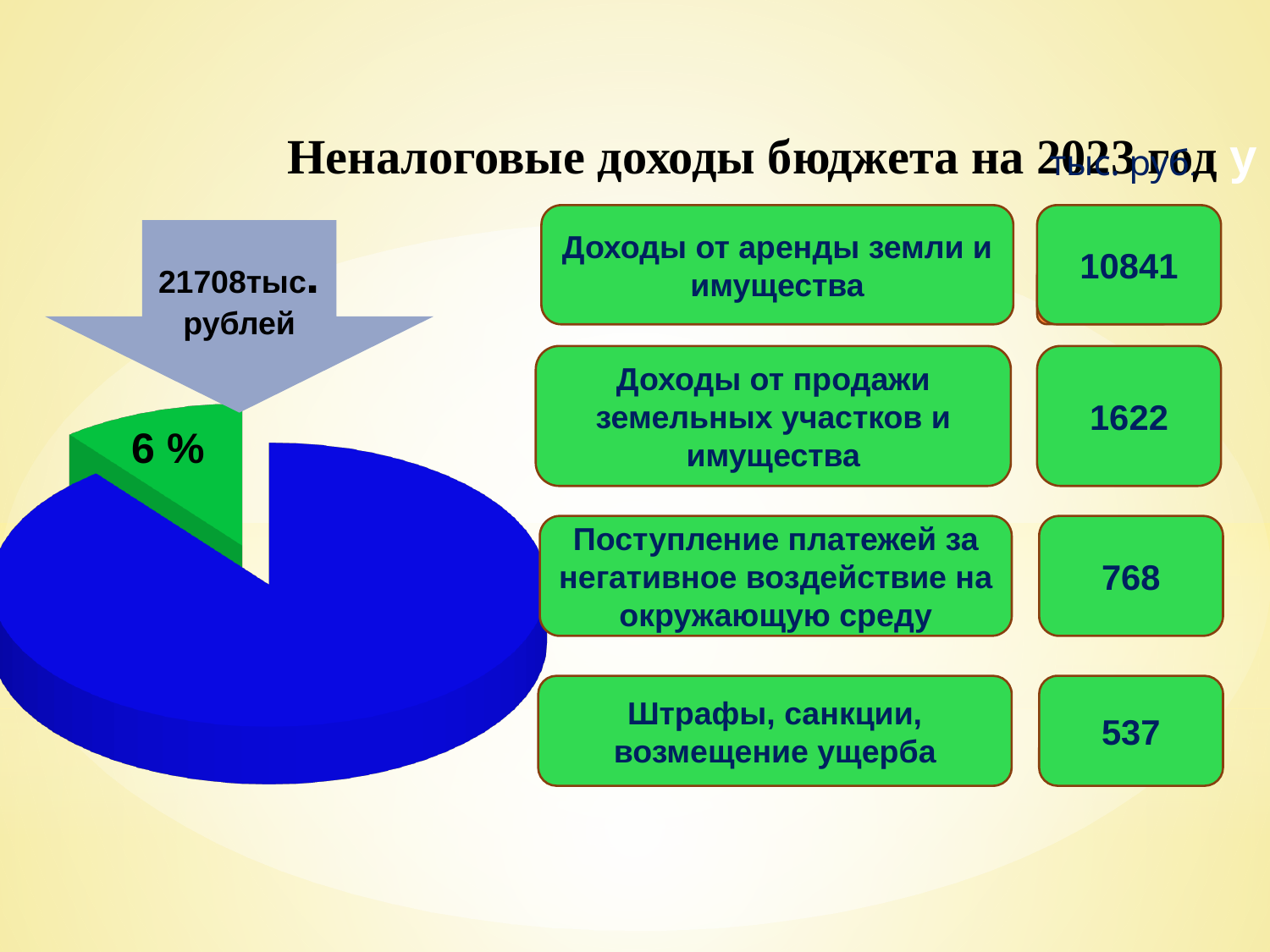
Which slice of the pie chart is the smallest? the green slice (6 %) What share of the pie does the green slice represent? 6 % How many slices does the pie chart have? 2 What kind of chart is shown on the slide? pie chart What is the title of the slide containing the pie chart? Неналоговые доходы бюджета на 2023 год What value is written in the arrow pointing to the green slice of the pie chart? 21708 тыс. рублей Which slice of the pie chart is the largest? the blue slice Which slice of the pie chart is larger, the blue one or the green one? the blue one What colour is the slice labelled 6 %? green